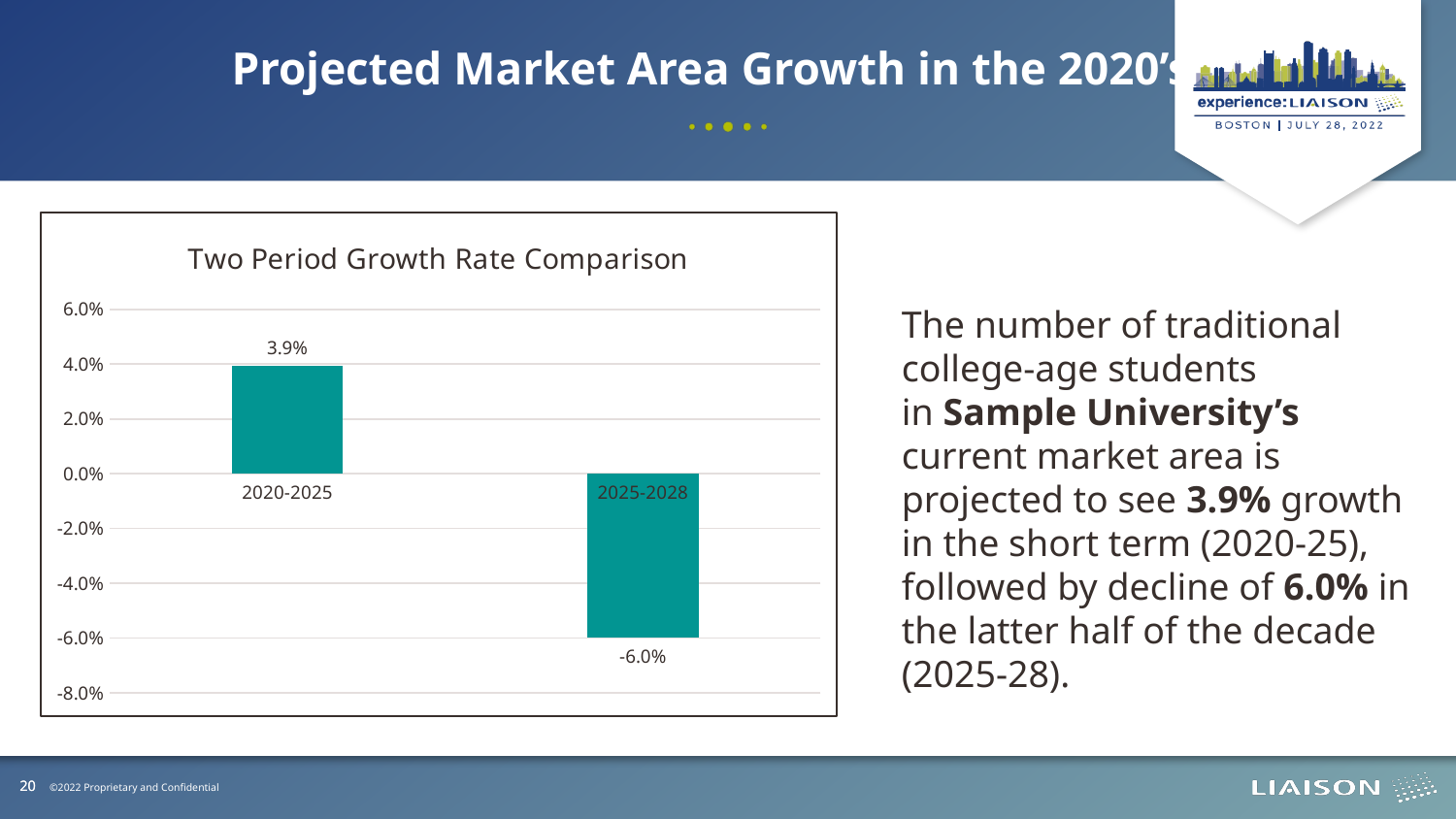
How many periods are shown in the chart? 2 Which period has the highest growth rate? 2020-2025 Is the value for 2020-2025 greater or less than 2.0%? greater Is the value for 2025-2028 greater or less than -4.0%? less Which is larger, the value for 2020-2025 or the value for 2025-2028? 2020-2025 What is the value for 2025-2028? -6.0% What is the value for 2020-2025? 3.9% What is the title of the chart? Two Period Growth Rate Comparison What is the difference between the 2020-2025 value and the 2025-2028 value? 9.9 percentage points Which period has the lowest growth rate? 2025-2028 Do the values rise or fall from 2020-2025 to 2025-2028? Fall What kind of chart is shown? Bar chart